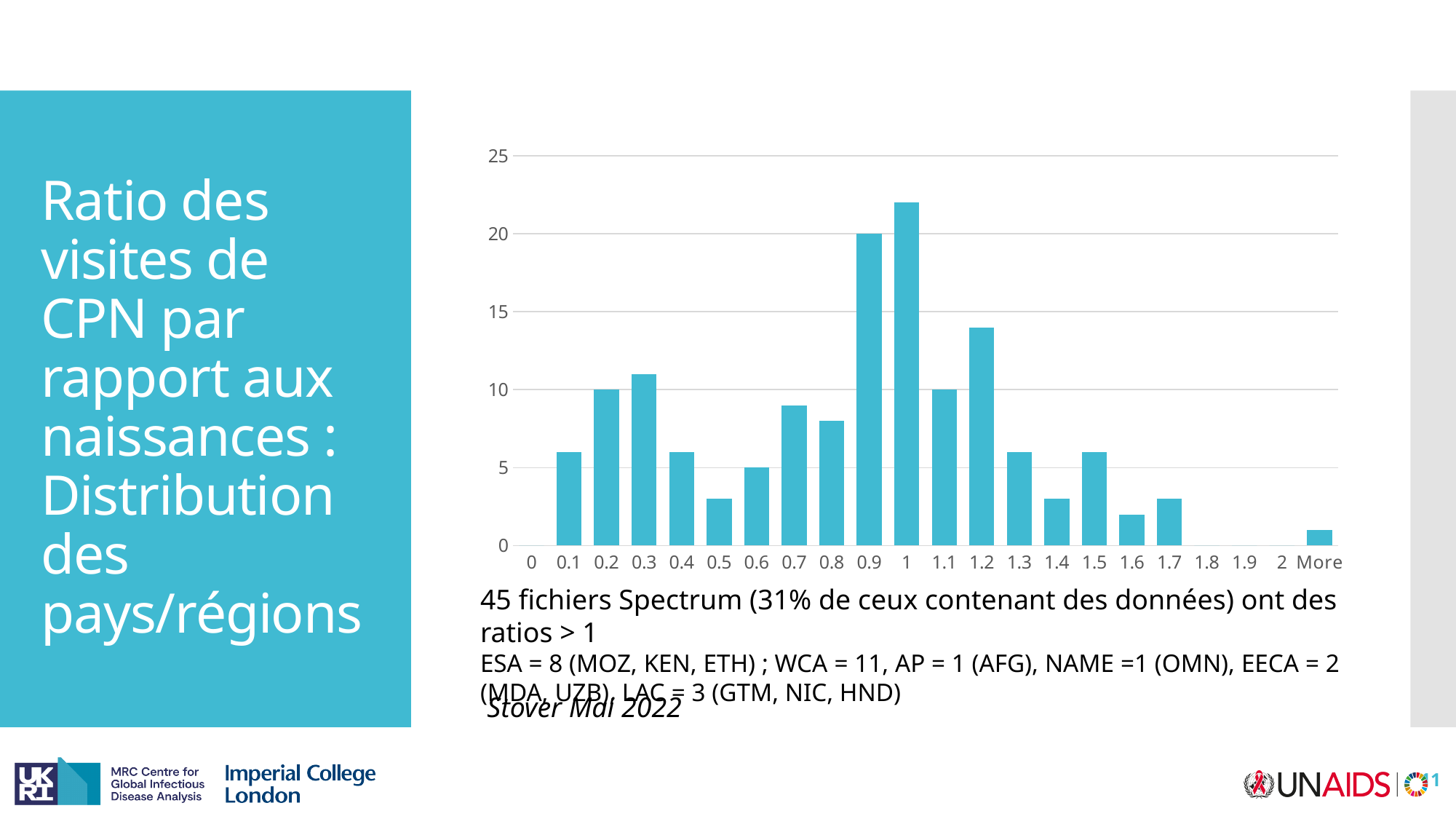
What is the difference between the bar at 0.9 and the bar at 0.2? 10 What kind of chart is shown on the slide? bar chart Which x-axis category has the tallest bar? 1 Is the value for 1.2 greater or less than 15? less Is the value for 0.5 greater or less than 5? less What is the value of the bar at 1.1? 10 What is the value of the bar at 0.6? 5 What is the value of the bar at 0.9? 20 Is the value for 1 greater or less than 20? greater What is the value of the bar at 0.2? 10 Which bar is taller, 0.9 or 1.2? 0.9 How many categories are labelled on the x axis? 22